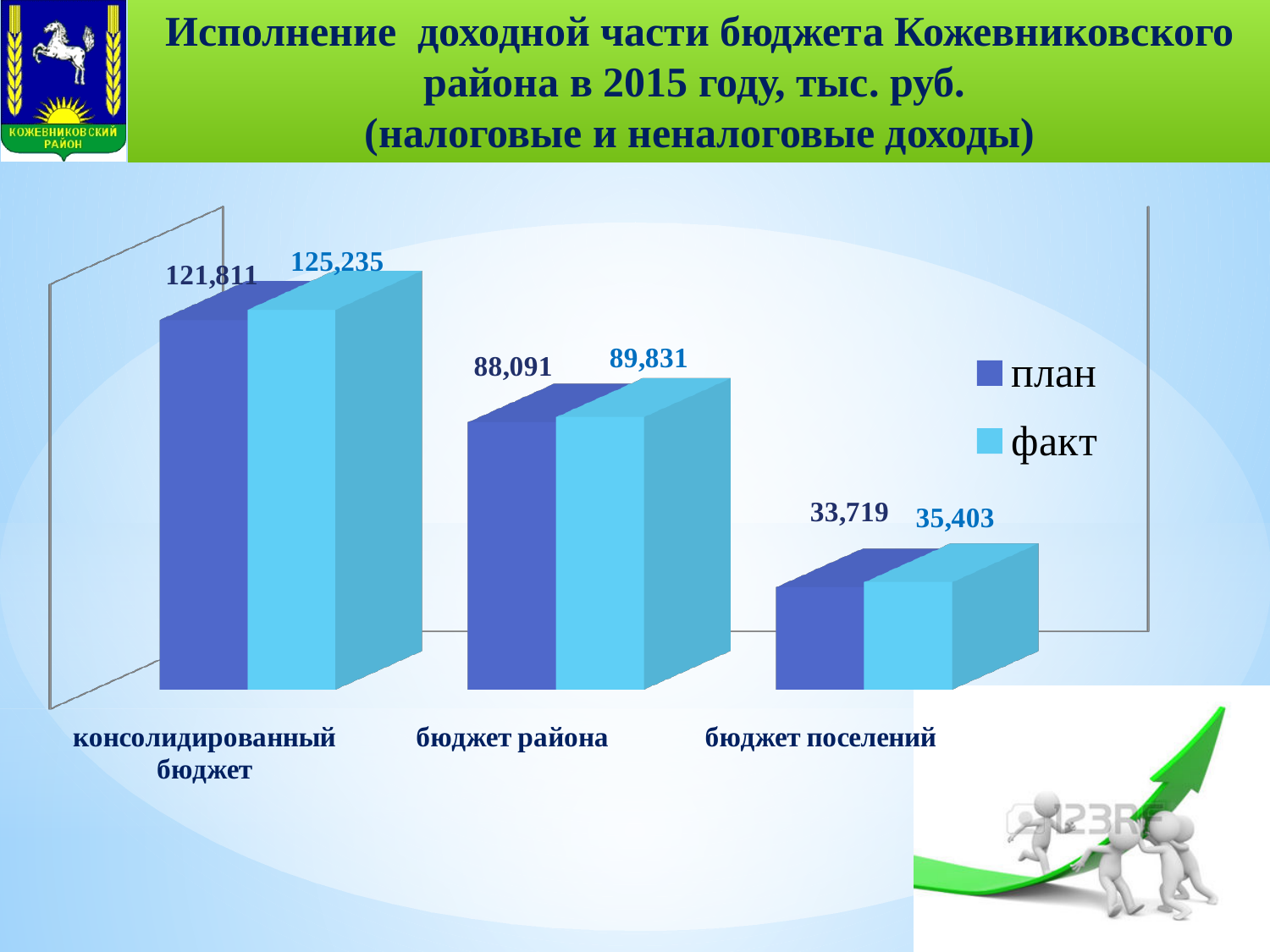
What is the difference between факт and план for консолидированный бюджет? 3,424 Which category has the lowest план value? бюджет поселений How many categories are shown on the x axis? 3 What kind of chart is shown on the slide? bar chart How many series does the legend list? 2 What is the факт value for бюджет района? 89,831 Which category has the highest факт value? консолидированный бюджет What is the difference between факт and план for бюджет района? 1,740 What is the план value for консолидированный бюджет? 121,811 For бюджет поселений, which is larger: план or факт? факт What is the факт value for бюджет поселений? 35,403 What is the план value for бюджет поселений? 33,719